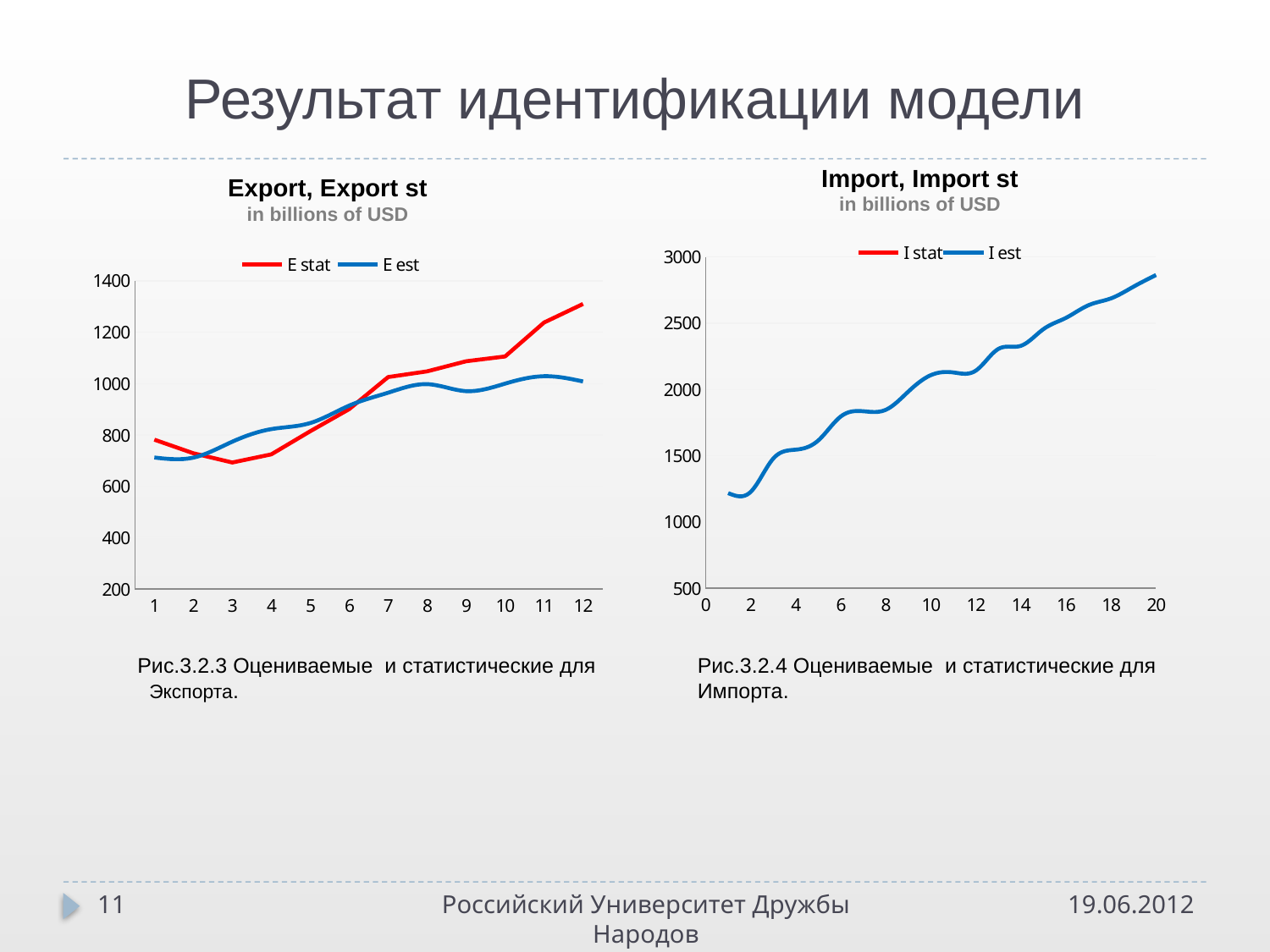
In the Export, Export st chart, which series is higher at x = 4, E stat or E est? E est In the Export, Export st chart, is the value of E stat at x = 3 greater or less than 800? less What are the two legend entries of the Import, Import st chart? I stat and I est What kind of chart is the Export, Export st chart on the left? line chart In the Import, Import st chart, is the value at x = 20 greater or less than 2500? greater In the Export, Export st chart, is the value of E stat at x = 12 greater or less than 1200? greater How many series does the legend of the Export, Export st chart list? 2 How many points along the x axis does the Export, Export st chart plot for each series? 12 In the Import, Import st chart, do the values generally rise or fall as x increases from 0 to 20? rise What unit is stated in the subtitle of the Import, Import st chart? in billions of USD In the Export, Export st chart, which series is higher at x = 12, E stat or E est? E stat